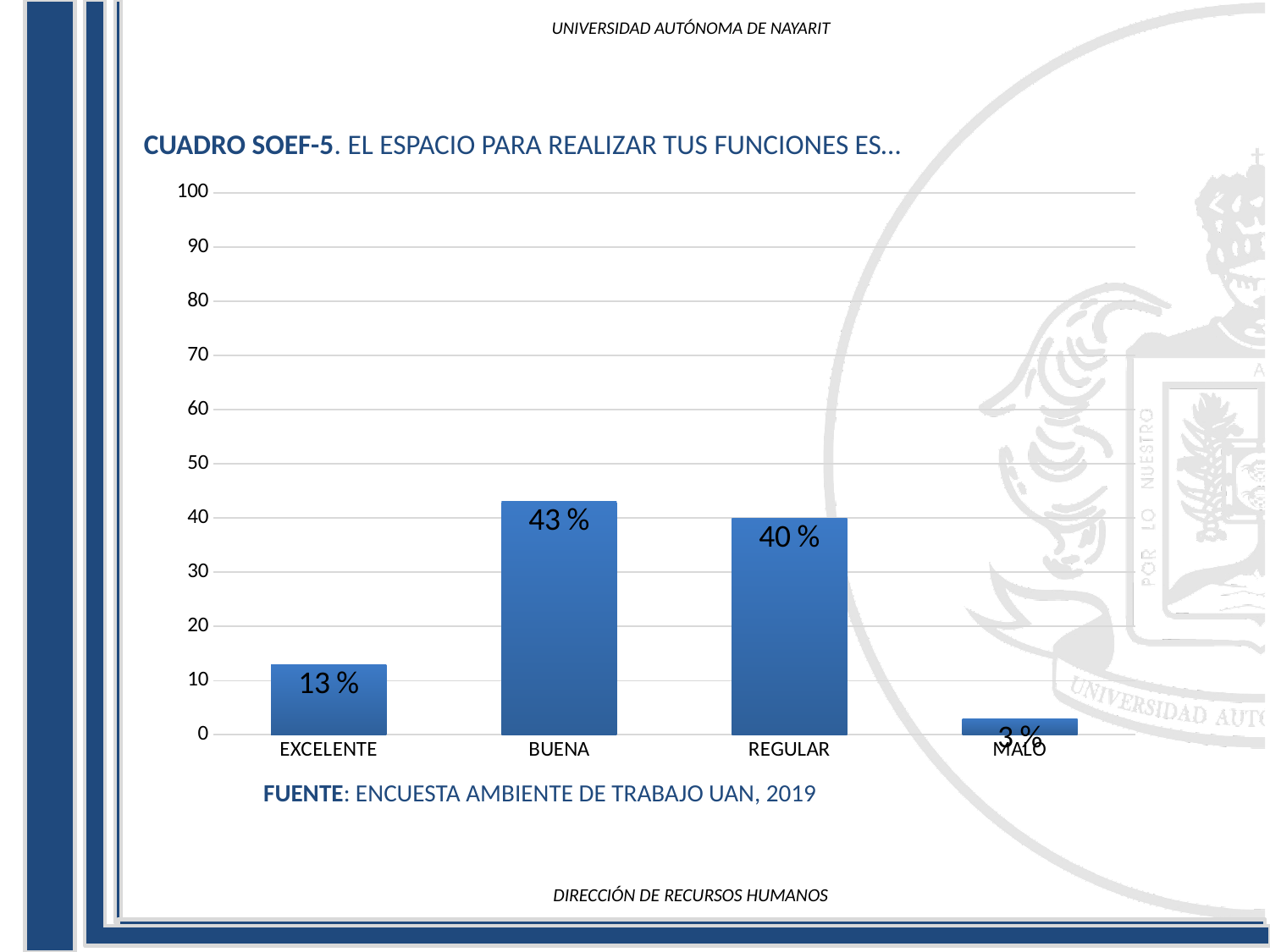
What is the difference between the values for BUENA and REGULAR? 3 % How many categories are shown on the x axis? 4 Which category has the lowest value? MALO What is the value for EXCELENTE? 13 % What is the difference between the values for REGULAR and EXCELENTE? 27 % Is the value for BUENA greater or less than 50? less What is the value for BUENA? 43 % Which category has the highest value? BUENA What kind of chart is shown on the slide? bar chart What is the value for REGULAR? 40 % Which is larger, the value for EXCELENTE or the value for REGULAR? REGULAR What is the source cited below the chart? ENCUESTA AMBIENTE DE TRABAJO UAN, 2019